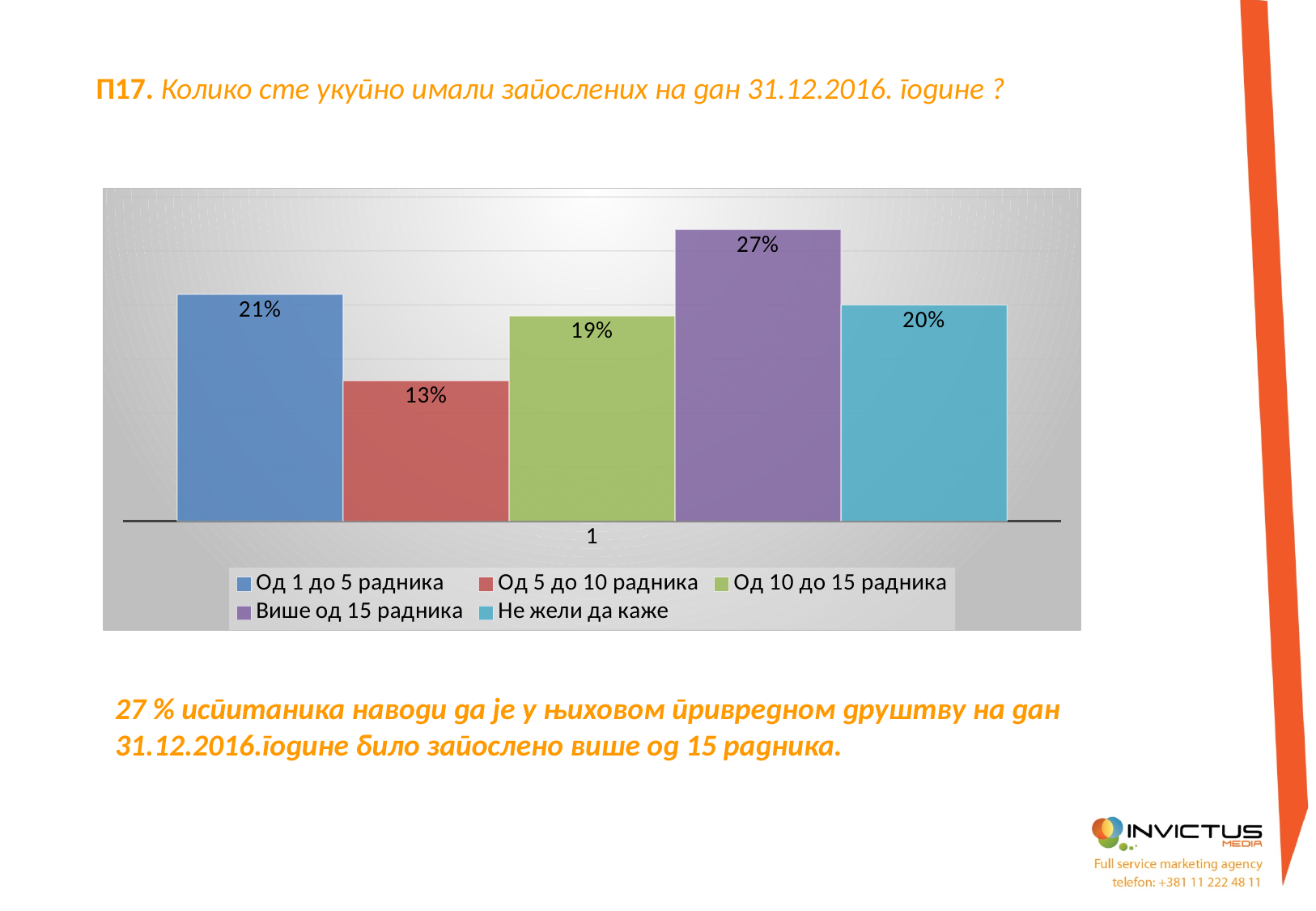
What colour is the bar for 'Више од 15 радника'? Purple What is the value for 'Од 10 до 15 радника'? 19% What is the difference between the values for 'Више од 15 радника' and 'Од 5 до 10 радника'? 14% What is the difference between the values for 'Од 1 до 5 радника' and 'Не жели да каже'? 1% Which series has the highest value? Више од 15 радника Which is larger, the value for 'Од 10 до 15 радника' or the value for 'Од 5 до 10 радника'? Од 10 до 15 радника Which series has the lowest value? Од 5 до 10 радника What is the value for 'Од 1 до 5 радника'? 21% How many series does the legend list? 5 What is the value for 'Од 5 до 10 радника'? 13% What is the value for 'Не жели да каже'? 20% What kind of chart is shown on the slide? Bar chart